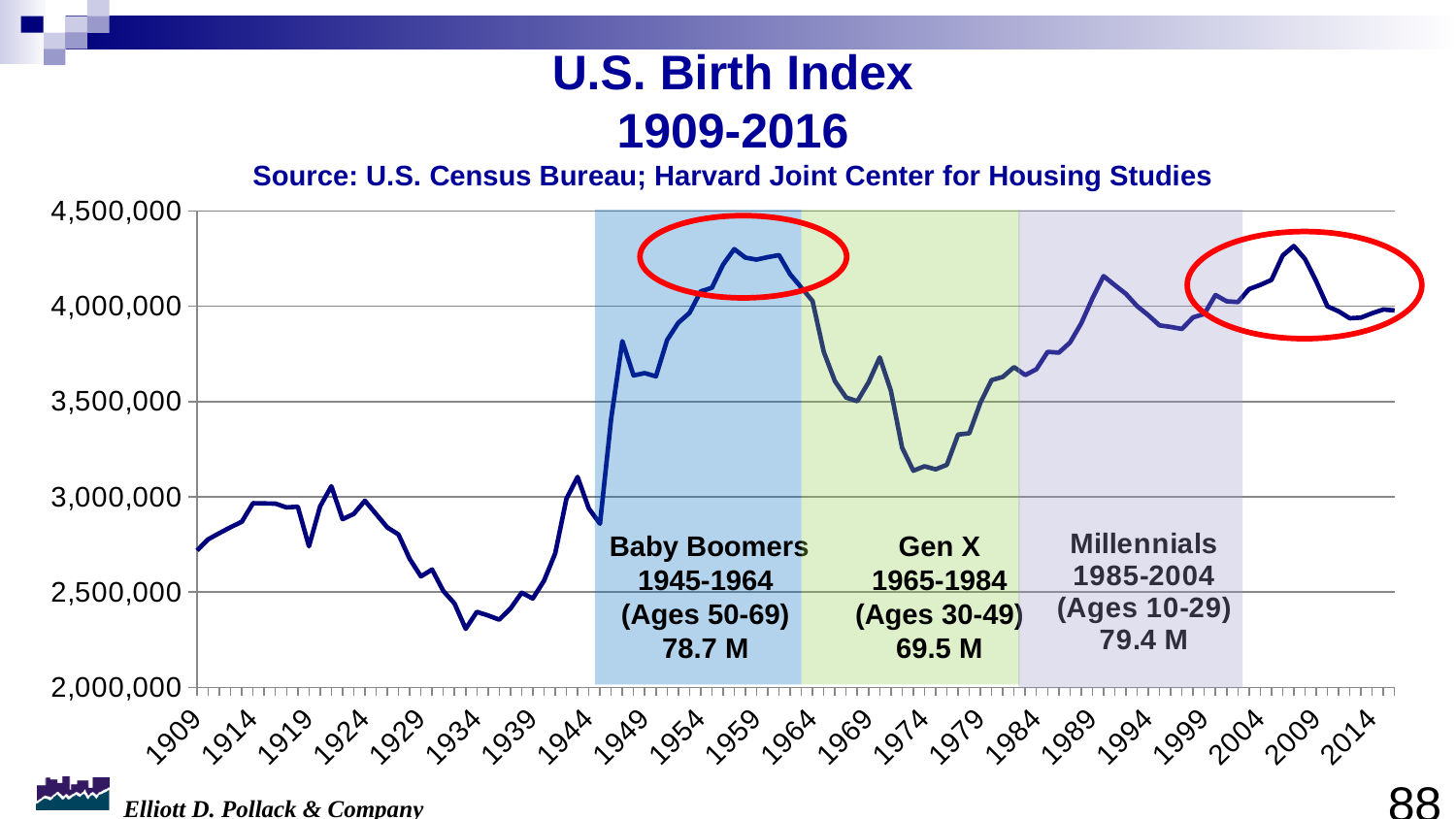
Which year has the larger value, 1959 or 1974? 1959 Is the value for 1909 greater or less than 2,500,000? greater Is the value for 1934 greater or less than 2,500,000? less What kind of chart is shown on the slide? line chart Which generation band on the chart covers the years 1965-1984? Gen X Do the values rise or fall from 1974 to 1989? rise How many shaded generation bands are marked on the chart? 3 Is the value for 1949 greater or less than 3,500,000? greater What is the title of the chart? U.S. Birth Index 1909-2016 Do the values rise or fall from 1929 to 1934? fall